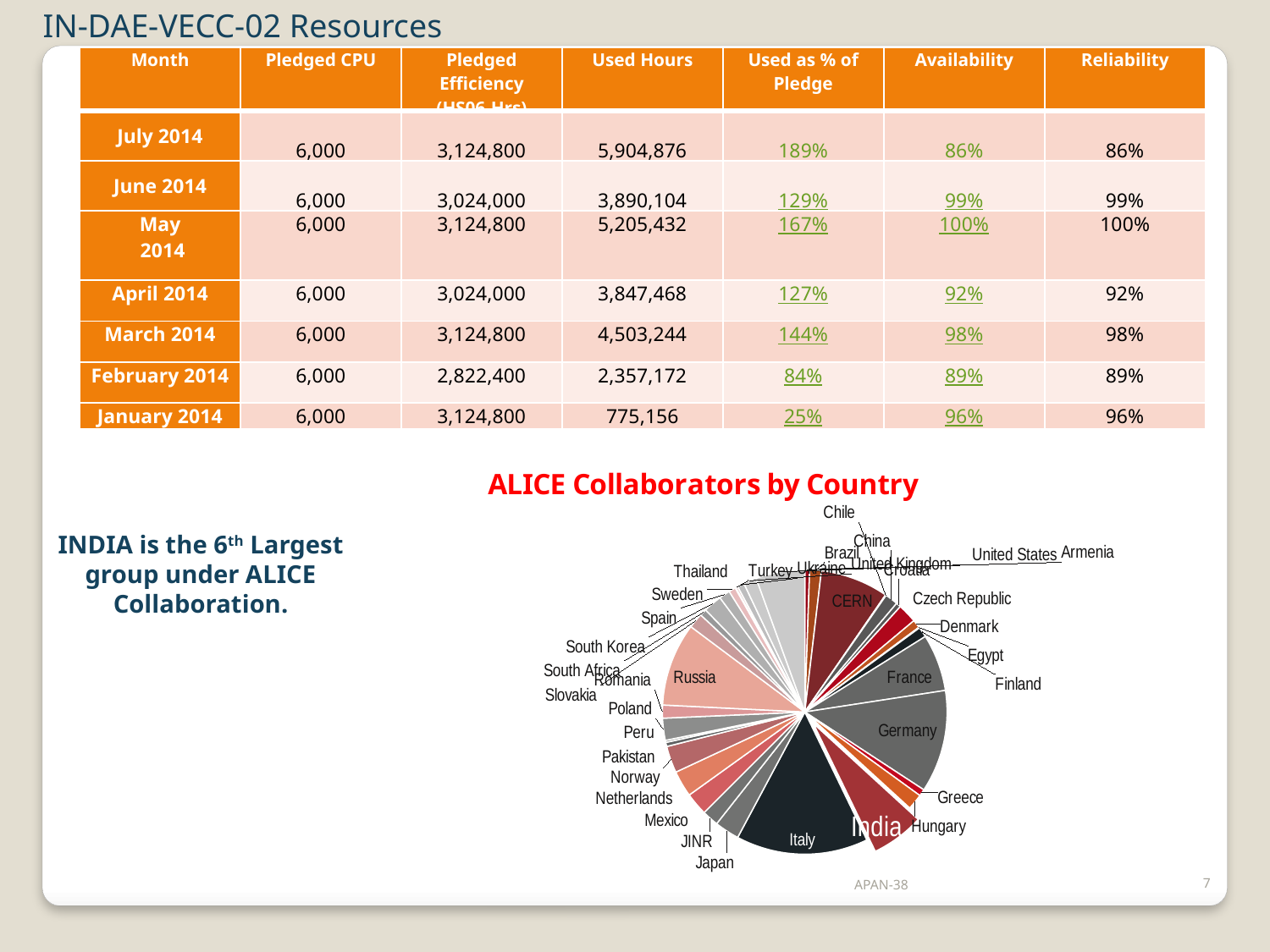
In the "ALICE Collaborators by Country" pie chart, which slice is larger, Italy or Chile? Italy What kind of chart is "ALICE Collaborators by Country"? pie chart According to the text next to the pie chart, what rank does India hold among groups under the ALICE Collaboration? 6th largest In the "ALICE Collaborators by Country" pie chart, which slice is larger, Germany or Denmark? Germany In the "ALICE Collaborators by Country" pie chart, which slice is larger, Italy or Hungary? Italy What is the title of the pie chart on the slide? ALICE Collaborators by Country In the "ALICE Collaborators by Country" pie chart, which country has the largest slice? Italy